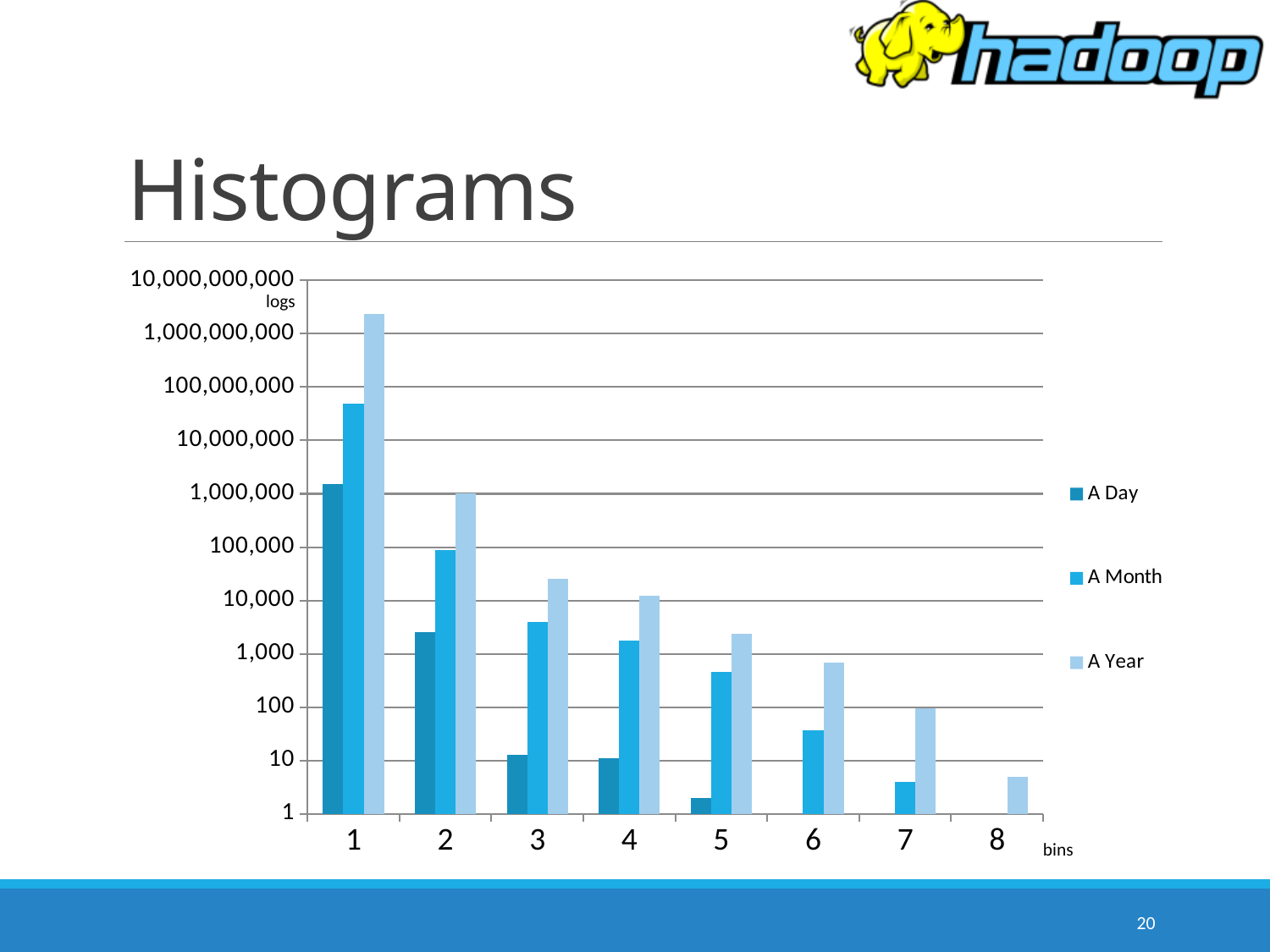
Is the value for A Year at bin 1 greater or less than 1,000,000,000? greater What kind of chart is shown on the slide? bar chart At bin 4, which is larger: A Day or A Month? A Month Is the value for A Month at bin 1 greater or less than 10,000,000? greater How many series does the legend list? 3 Do the A Year values rise or fall as the bin number increases? fall Is the value for A Day at bin 3 greater or less than 100? less How many bins are shown on the x axis? 8 What label is shown on the y axis of the chart? logs Which bin has the highest value for A Year? 1